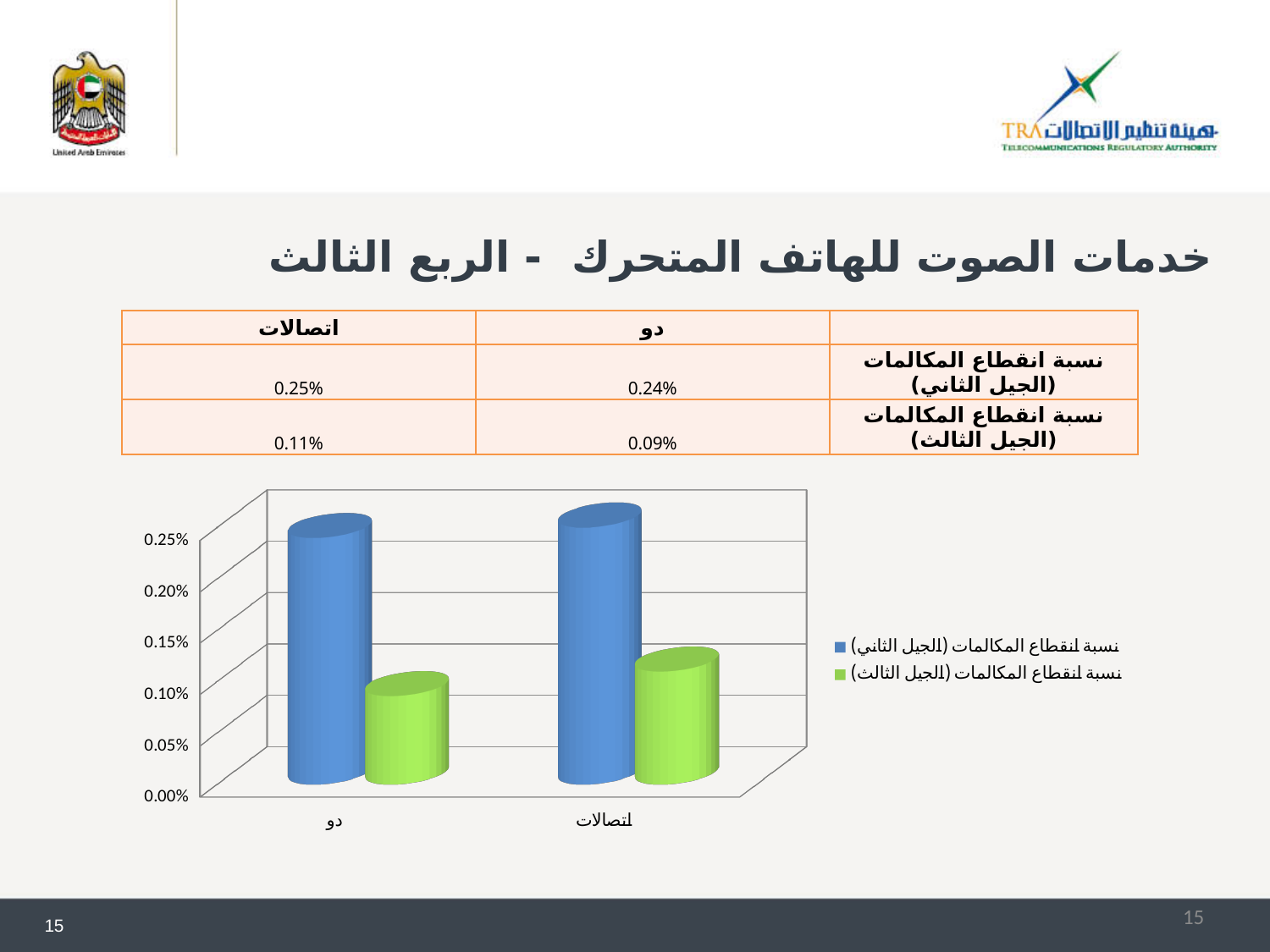
In the chart, is the 3G call drop rate bar for دو greater or less than 0.10%? less According to the slide, what is the 2G call drop rate (نسبة انقطاع المكالمات (الجيل الثاني)) for اتصالات? 0.25% What is the difference between the 3G call drop rates of اتصالات and دو? 0.02% What type of chart is shown on the slide? bar chart How many categories (operators) are shown on the x axis of the chart? 2 According to the slide, what is the 2G call drop rate for دو? 0.24% Which colour represents the 3G call drop rate series (الجيل الثالث) in the chart? green For اتصالات, which is larger: the 2G call drop rate or the 3G call drop rate? 2G call drop rate (الجيل الثاني) How many series does the chart legend list? 2 According to the slide, what is the 3G call drop rate for اتصالات? 0.11% What is the difference between the 2G and 3G call drop rates for دو? 0.15% According to the slide, what is the 3G call drop rate (نسبة انقطاع المكالمات (الجيل الثالث)) for دو? 0.09%